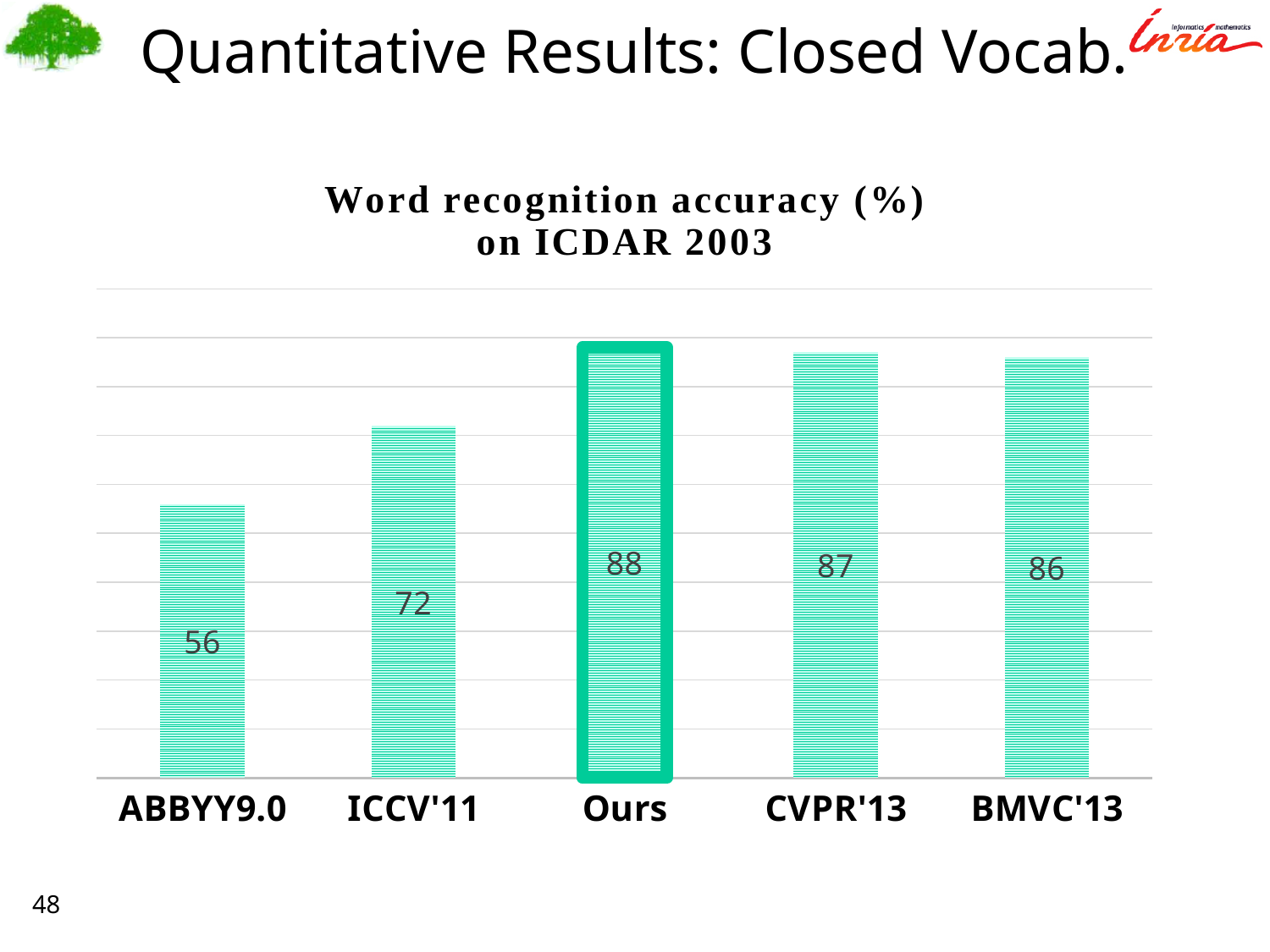
Which method has the lowest word recognition accuracy? ABBYY9.0 Which method has the highest word recognition accuracy? Ours What is the word recognition accuracy for ABBYY9.0? 56 Which has a higher accuracy, ICCV'11 or BMVC'13? BMVC'13 What is the difference in accuracy between ICCV'11 and ABBYY9.0? 16 What is the word recognition accuracy for ICCV'11? 72 What is the word recognition accuracy for CVPR'13? 87 What is the difference in accuracy between Ours and ABBYY9.0? 32 What is the word recognition accuracy for Ours? 88 How many methods are compared in the chart? 5 What type of chart is shown on the slide? Bar chart What is the word recognition accuracy for BMVC'13? 86